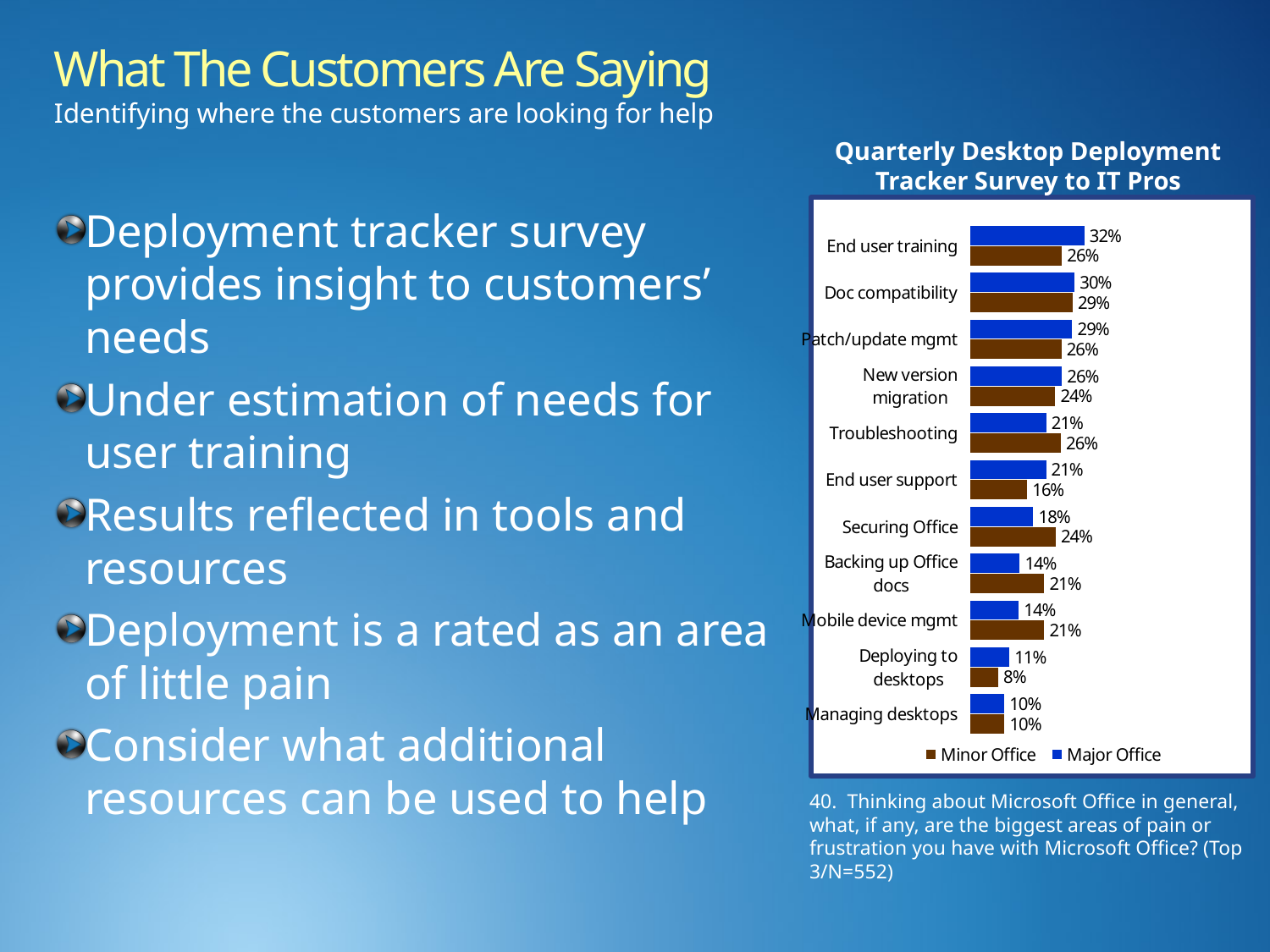
For Securing Office, which is larger: the Minor Office value or the Major Office value? Minor Office Which category has the lowest Minor Office value? Deploying to desktops What kind of chart is shown on the slide? Bar chart What is the Minor Office value for Deploying to desktops? 8% What is the title of the chart? Quarterly Desktop Deployment Tracker Survey to IT Pros What is the difference between the Major Office and Minor Office values for End user training? 6% Which series is shown in blue in the chart? Major Office What is the Major Office value for End user training? 32% How many series does the legend list? 2 How many categories are shown in the chart? 11 Which category has the highest Major Office value? End user training What is the Minor Office value for Troubleshooting? 26%